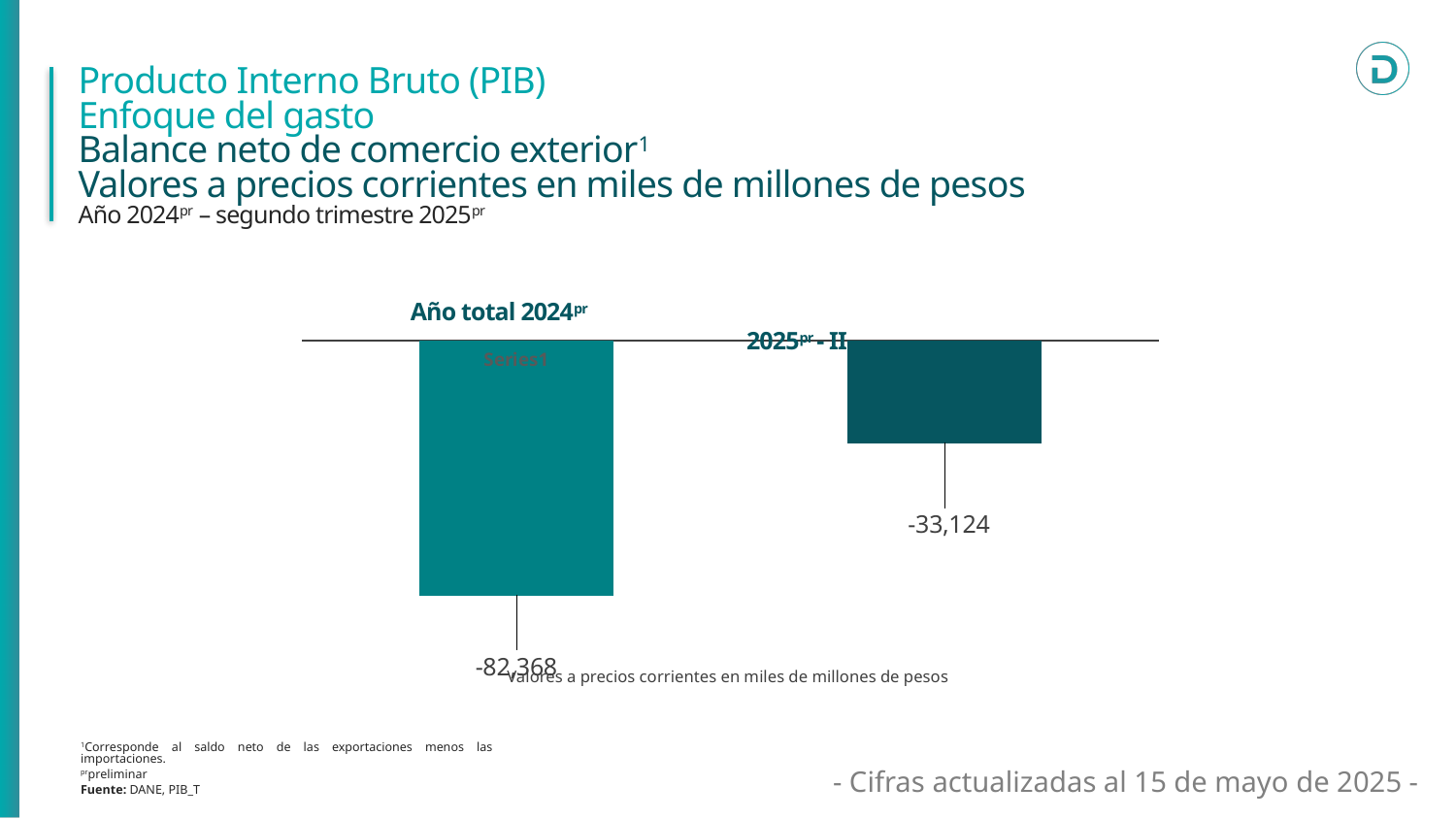
What is the difference between the values for Año total 2024pr and 2025pr - II? 49,244 How many bars are plotted in the chart? 2 Are both plotted values negative or positive? Negative Which bar extends further below the zero line, Año total 2024pr or 2025pr - II? Año total 2024pr Which category has the highest (least negative) value? 2025pr - II What is the value shown for Año total 2024pr? -82,368 Which category has the lowest (most negative) value? Año total 2024pr What kind of chart is shown on the slide? Bar chart What unit does the chart's axis label say the values are in? Miles de millones de pesos What is the value shown for 2025pr - II? -33,124